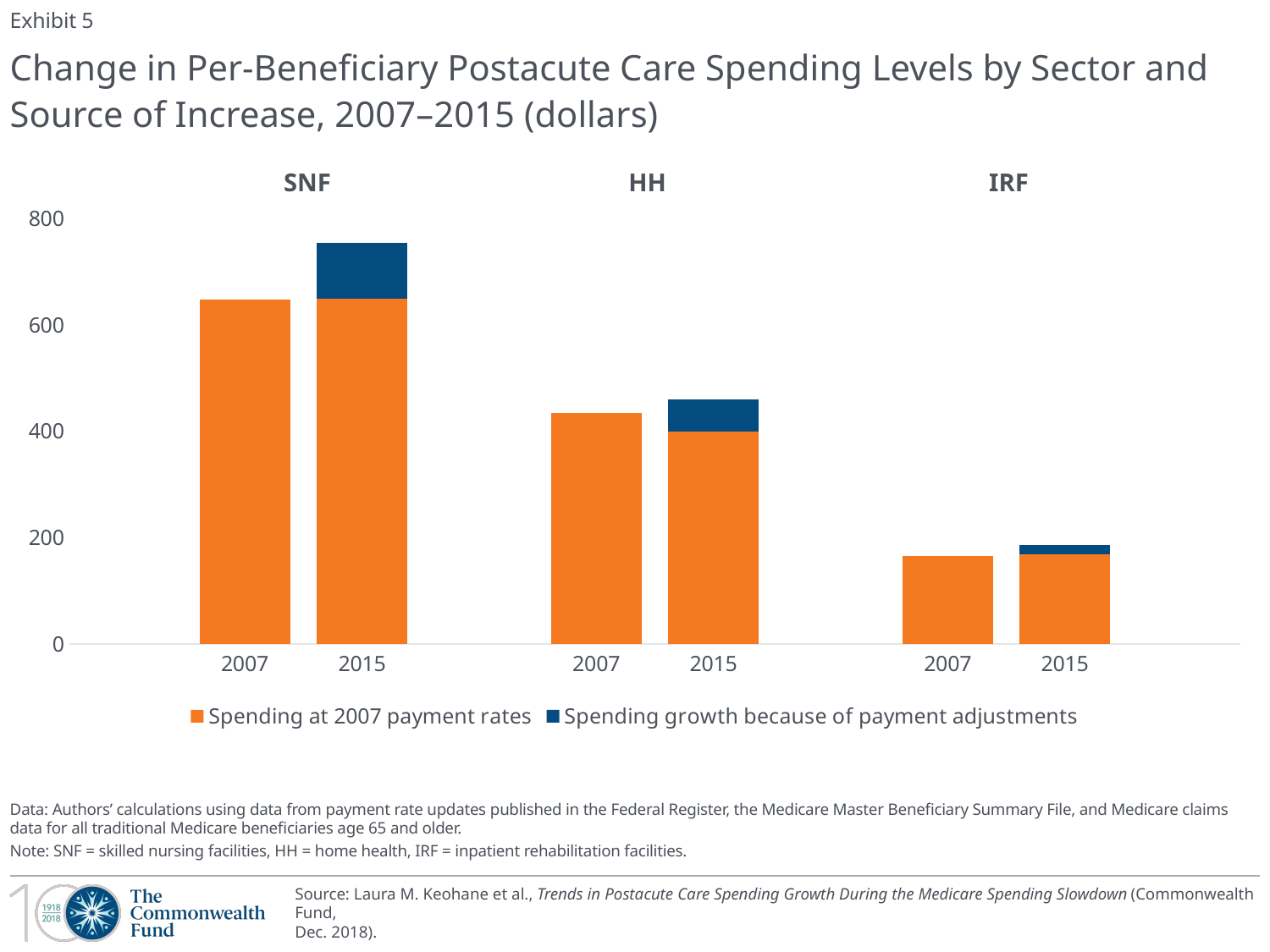
Which bar is the shortest in the chart? IRF 2007 Is the value for SNF in 2007 greater or less than 600? greater Within each sector, does the total spending rise or fall from 2007 to 2015? rise How many bars are plotted in the chart? 6 How many series does the legend list? 2 What type of chart is shown on the slide? Bar chart Which is larger: the total bar for SNF 2015 or the total bar for HH 2015? SNF 2015 Which is larger: the bar for HH 2007 or the total bar for IRF 2015? HH 2007 What colour represents 'Spending growth because of payment adjustments' in the legend? Blue Is the total value for SNF in 2015 greater or less than 700? greater Is the value for IRF in 2007 greater or less than 200? less Which bar is the tallest in the chart? SNF 2015